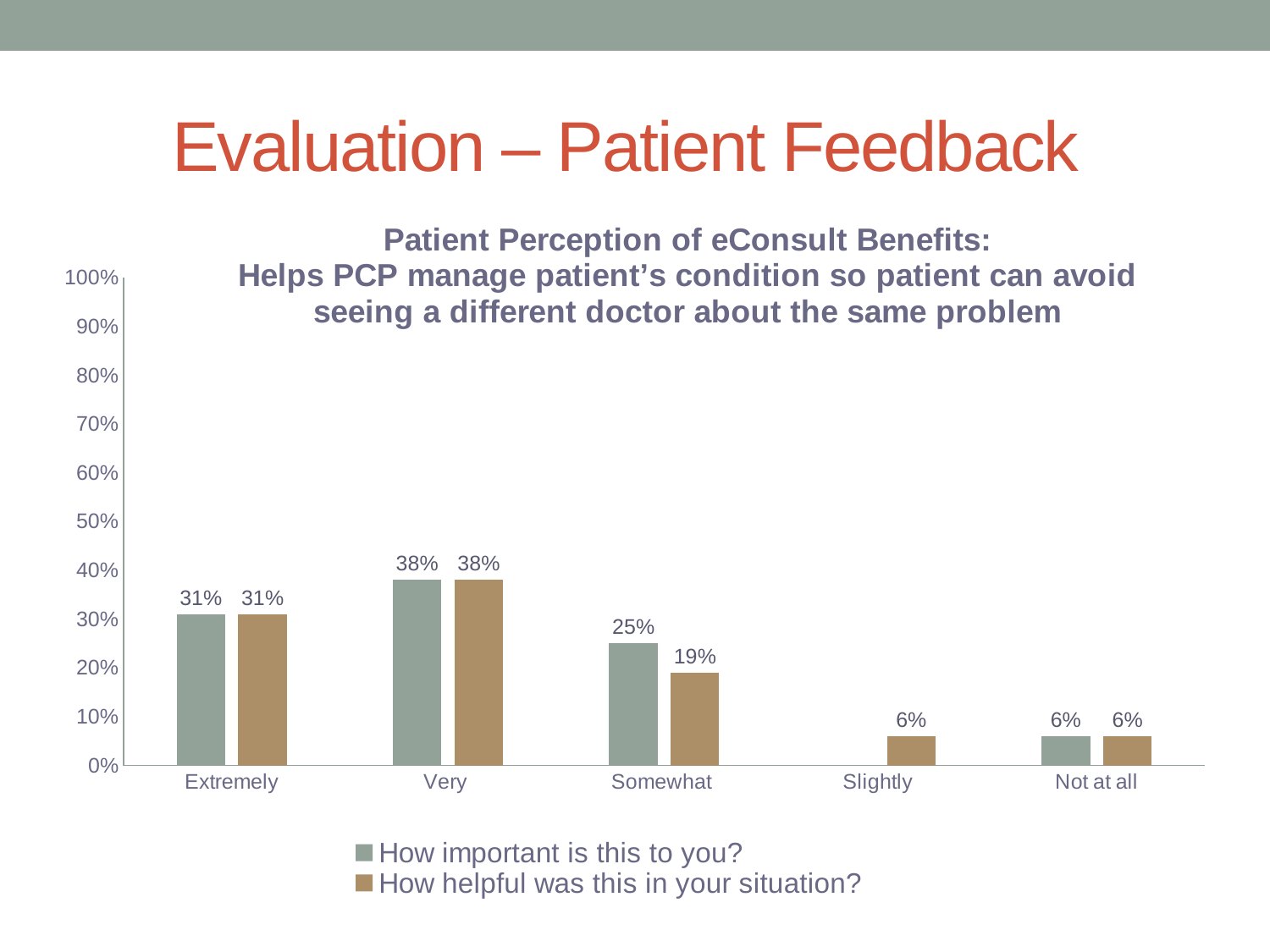
For the "Somewhat" category, which series has the larger value? How important is this to you? What is the value for "Slightly" in the "How helpful was this in your situation?" series? 6% What is the value for "Somewhat" in the "How important is this to you?" series? 25% What is the value for "Extremely" in the "How important is this to you?" series? 31% How many series does the legend list? 2 What is the value for "Somewhat" in the "How helpful was this in your situation?" series? 19% Is the value for "Very" in the "How important is this to you?" series greater or less than 30%? greater What kind of chart is shown on the slide? Bar chart Which category has the lowest value in the "How helpful was this in your situation?" series? Slightly and Not at all (both 6%) How many categories are shown on the x axis? 5 Which category has the highest value in the "How important is this to you?" series? Very What is the difference between the two series for the "Somewhat" category? 6%